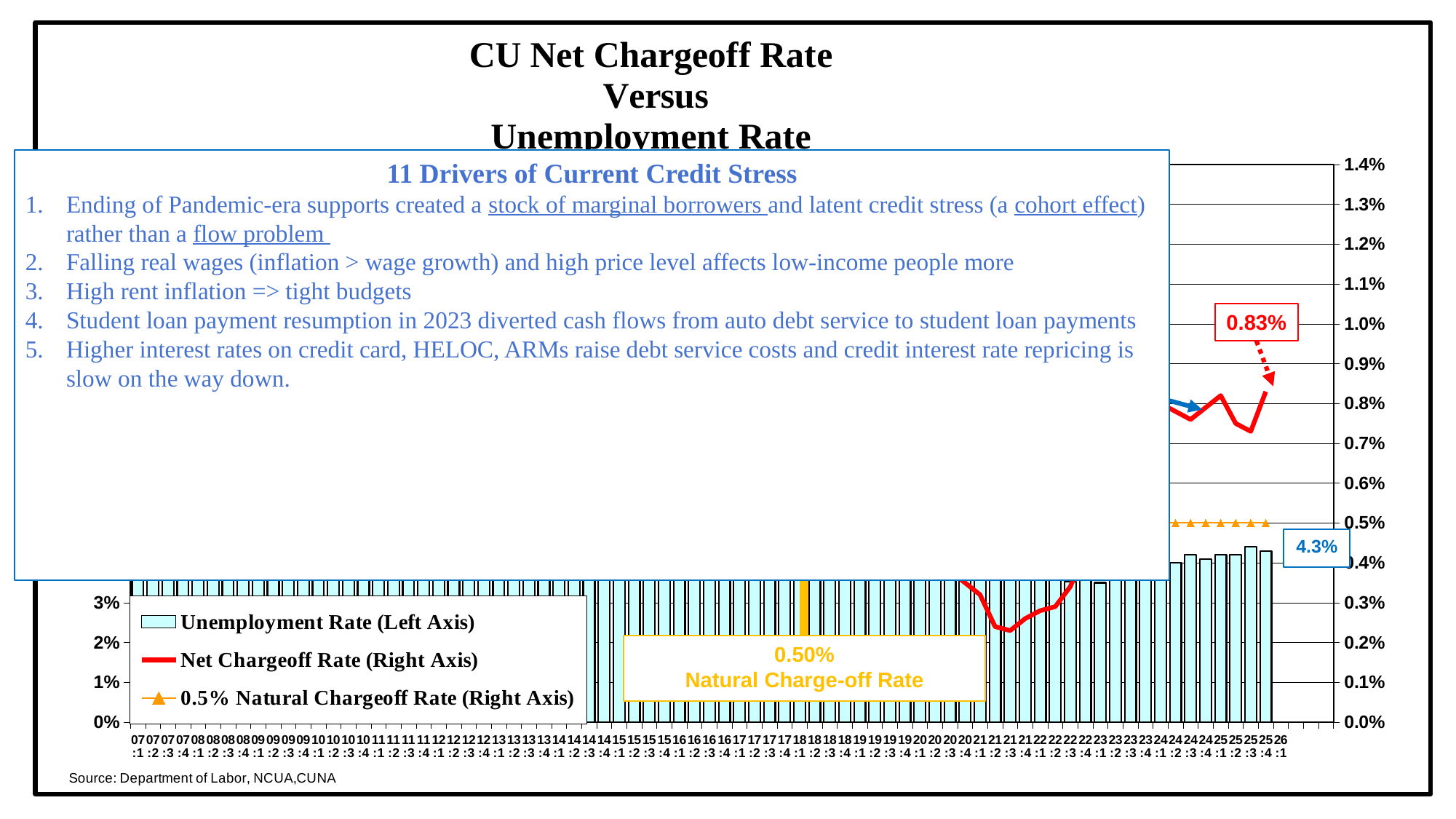
On which axis is the Unemployment Rate plotted? Left Axis Is the Net Chargeoff Rate in mid-2021 greater or less than 0.3% on the right axis? less Is the latest labeled Net Chargeoff Rate (0.83%) greater or less than the 0.50% Natural Chargeoff Rate? greater What value is given for the Natural Charge-off Rate? 0.50% Does the Net Chargeoff Rate rise or fall from 2021 to 2023? rise By how much does the latest labeled Net Chargeoff Rate (0.83%) exceed the 0.50% Natural Charge-off Rate? 0.33% What is the title of the chart? CU Net Chargeoff Rate Versus Unemployment Rate What is the most recent Unemployment Rate value labeled on the chart? 4.3% What kind of chart is this? Combination bar and line chart What is the most recent Net Chargeoff Rate value labeled on the chart? 0.83% What is the highest tick value shown on the right axis? 1.4% How many series does the chart legend list? 3